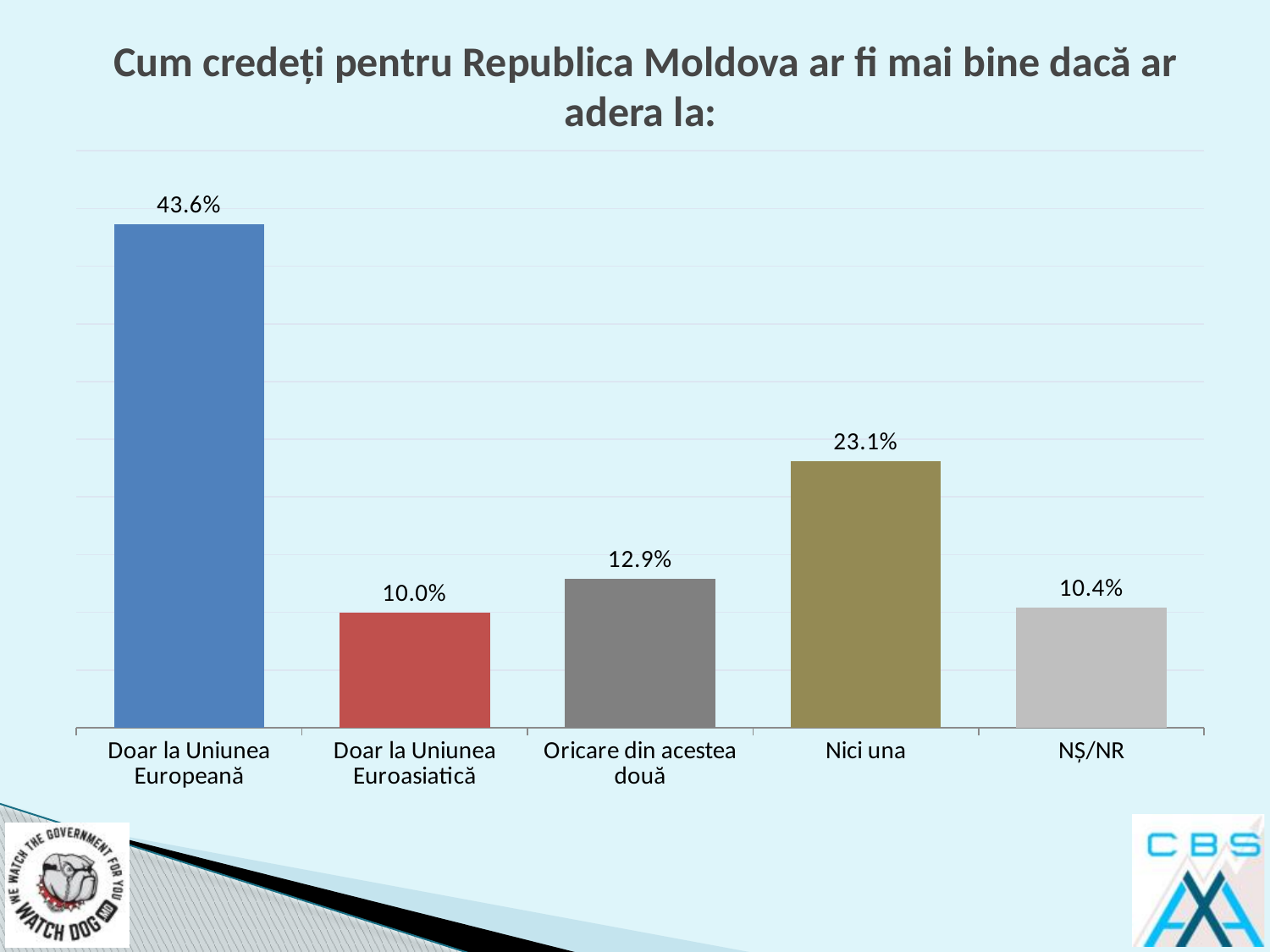
What is the value for "Nici una"? 23.1% What kind of chart is shown on the slide? Bar chart Which category has the lowest value? Doar la Uniunea Euroasiatică What is the value for "Oricare din acestea două"? 12.9% How many categories are shown in the chart? 5 Which category has the highest value? Doar la Uniunea Europeană What is the difference between the values for "Doar la Uniunea Europeană" and "Nici una"? 20.5% What is the value for "Doar la Uniunea Europeană"? 43.6% What is the value for "Doar la Uniunea Euroasiatică"? 10.0% What is the value for "NȘ/NR"? 10.4% What colour is the bar for "Nici una"? Olive/khaki Which is larger, the value for "Oricare din acestea două" or the value for "NȘ/NR"? Oricare din acestea două